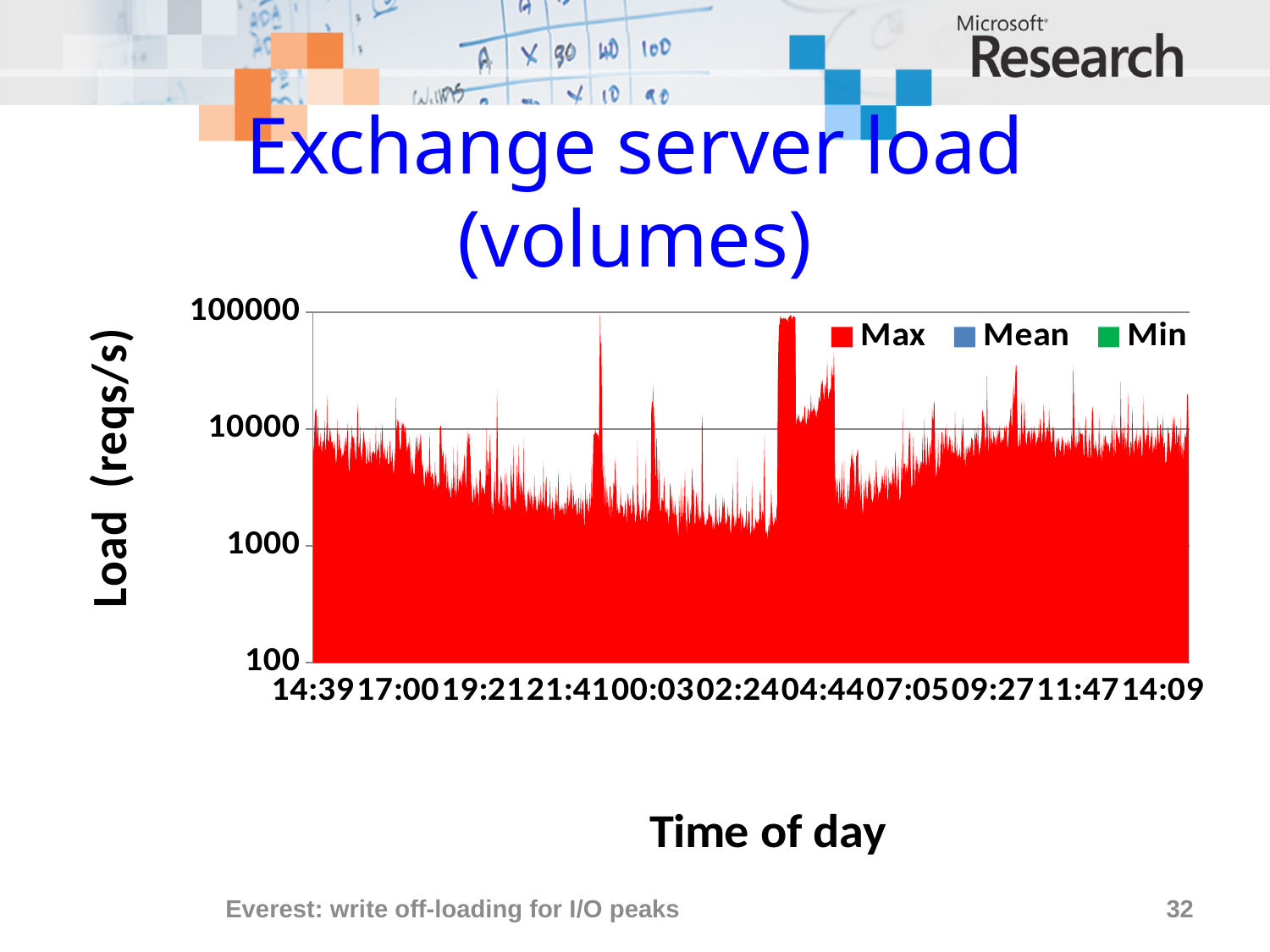
How many series does the chart legend list? 3 How many time labels are shown on the x-axis? 11 What is the title of the chart? Exchange server load (volumes) What is the lowest value shown on the y-axis? 100 What is the first time label on the x-axis? 14:39 Is the load at 02:24 greater or less than 10000? less Does the load generally rise or fall from 07:05 to 14:09? rise Is the peak load between 02:24 and 04:44 greater or less than 10000? greater